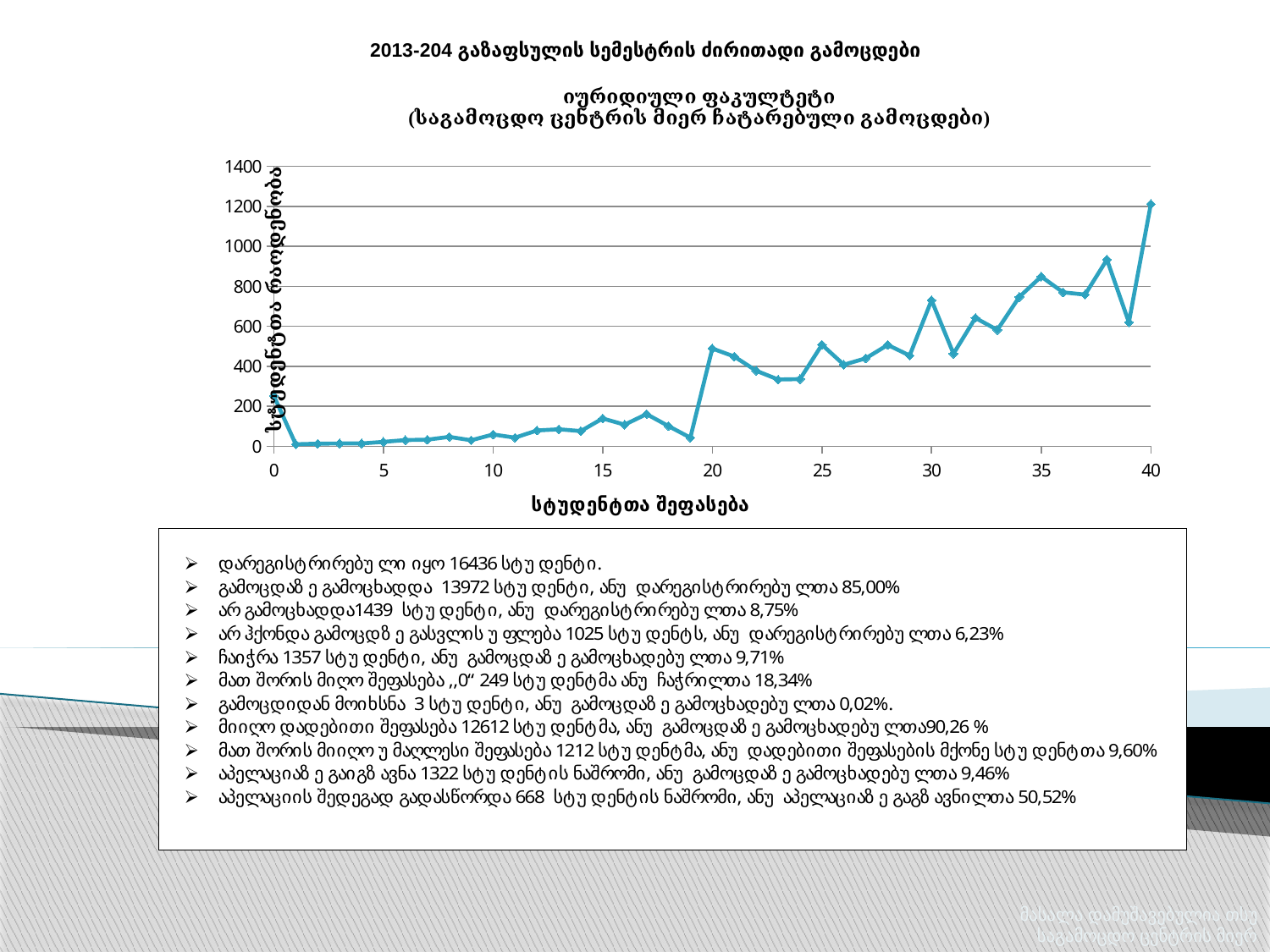
Overall, do the values rise or fall as the x-axis value increases from 0 to 40? rise Is the value at x = 10 greater or less than 200? less Is the value at x = 20 greater or less than 400? greater Which has the larger value, x = 30 or x = 31? x = 30 Which has the larger value, x = 38 or x = 39? x = 38 What kind of chart is shown on the slide? line chart At which x-axis value (student score) does the line reach its highest point? 40 Is the value at x = 40 greater or less than 1000? greater What is the highest tick value shown on the y-axis? 1400